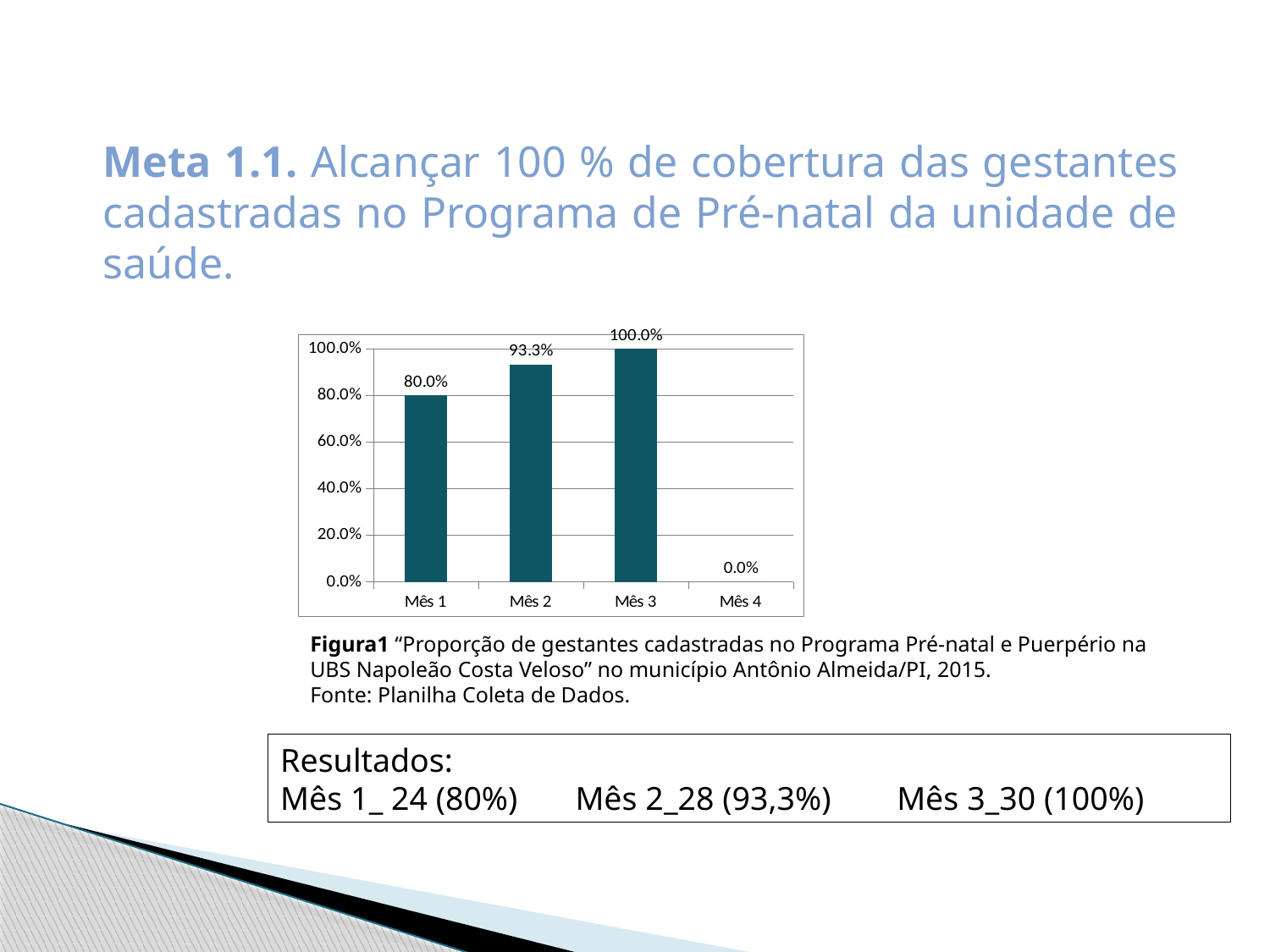
What is the difference between the values for Mês 2 and Mês 1? 13.3% What is the value for Mês 1? 80.0% Do the values rise or fall from Mês 1 to Mês 3? Rise How many categories are shown on the x axis? 4 Which month has the lowest value? Mês 4 What kind of chart is shown on the slide? Bar chart What is the value for Mês 4? 0.0% What is the value for Mês 3? 100.0% Which month has the highest value? Mês 3 What is the value for Mês 2? 93.3% Which is larger, the value for Mês 2 or the value for Mês 1? Mês 2 What is the difference between the values for Mês 3 and Mês 1? 20.0%